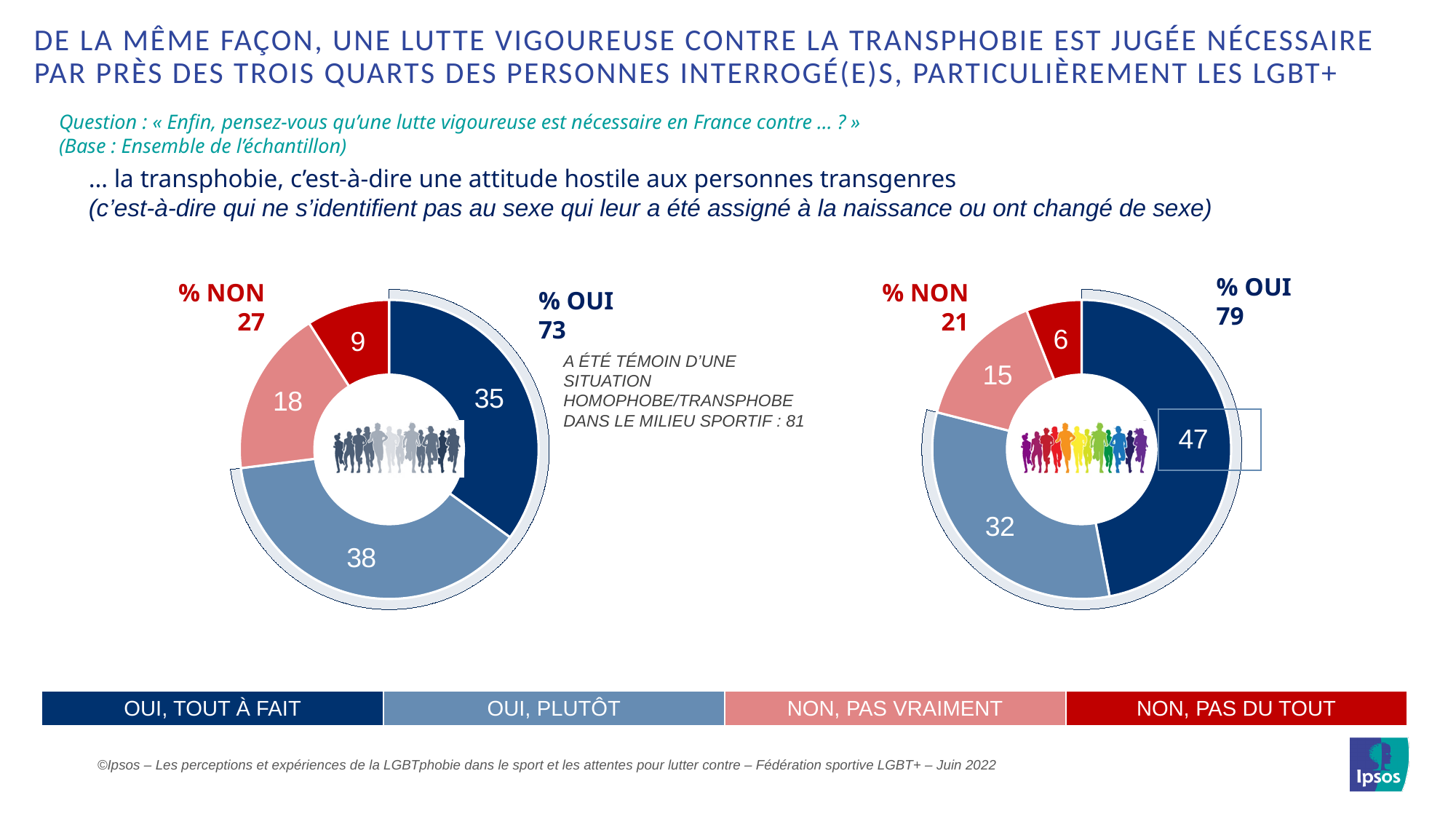
In the left donut chart, what is the value for "Non, pas du tout"? 9 What is the difference between the "Oui, tout à fait" values in the right and left donut charts? 12 In the right donut chart, which category has the smallest value? Non, pas du tout What is the total % OUI shown for the right donut chart? 79 How many categories does the legend at the bottom of the slide list? 4 In the right donut chart, what is the value for "Oui, tout à fait"? 47 In the left donut chart, which category has the largest value? Oui, plutôt What type of chart is used on this slide? Donut (pie) chart In the left donut chart, what is the value for "Oui, tout à fait"? 35 Which is larger in the left donut chart: "Oui, plutôt" or "Non, pas vraiment"? Oui, plutôt In the right donut chart, what is the value for "Non, pas vraiment"? 15 What is the total % NON shown for the left donut chart? 27